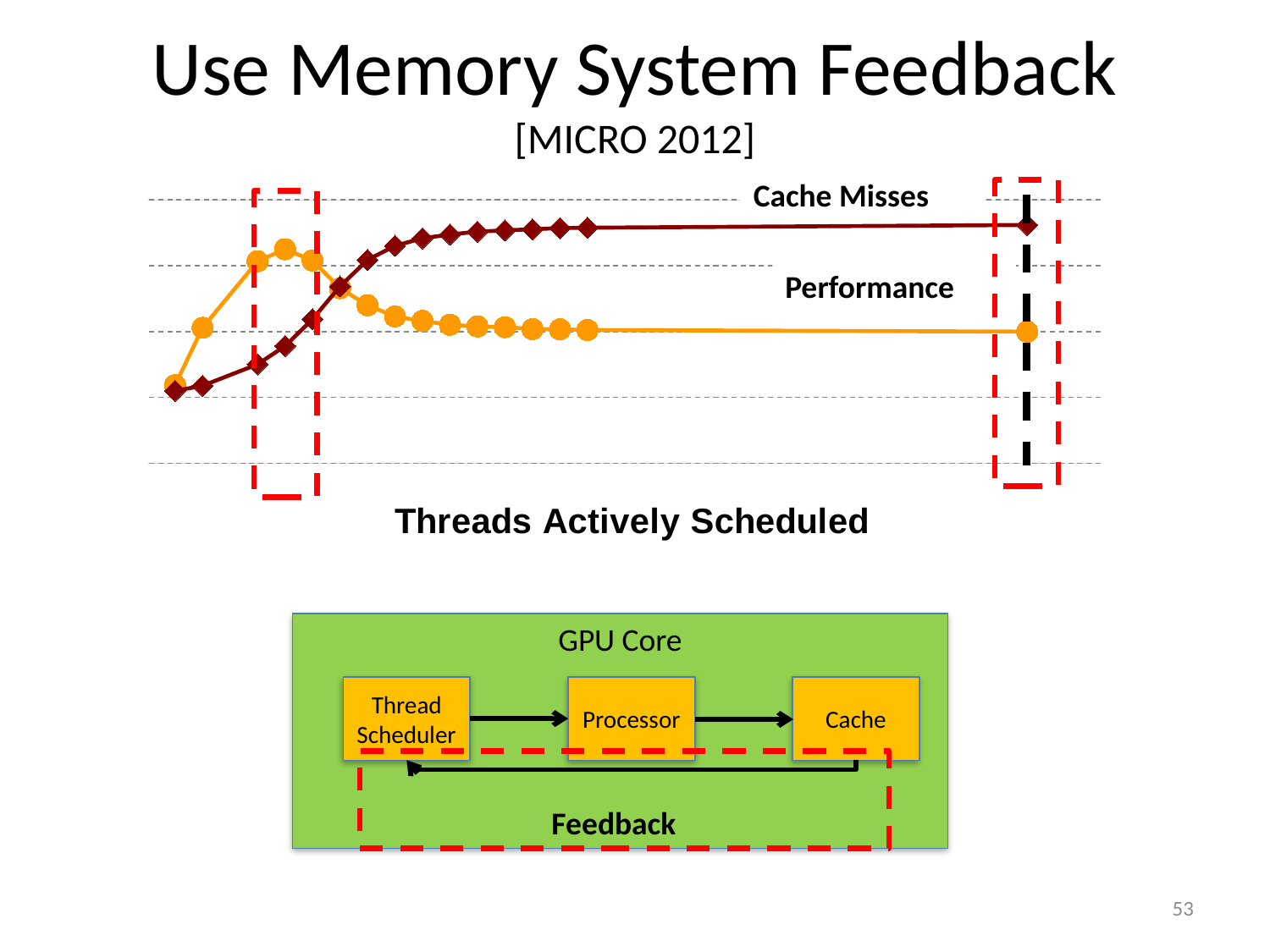
At the far right of the chart, which series is higher: Cache Misses or Performance? Cache Misses How many data series are plotted on the chart? 2 What is the label of the x axis of the chart? Threads Actively Scheduled What kind of chart is shown on the slide? line chart Which series reaches the highest point on the chart overall? Cache Misses Inside the left red dashed box, where Performance peaks, which series is higher: Performance or Cache Misses? Performance How does the Performance series change as Threads Actively Scheduled increases? rises to a peak, then falls and levels off How does the Cache Misses series change as Threads Actively Scheduled increases? rises, then levels off What are the names of the two series plotted on the chart? Cache Misses and Performance